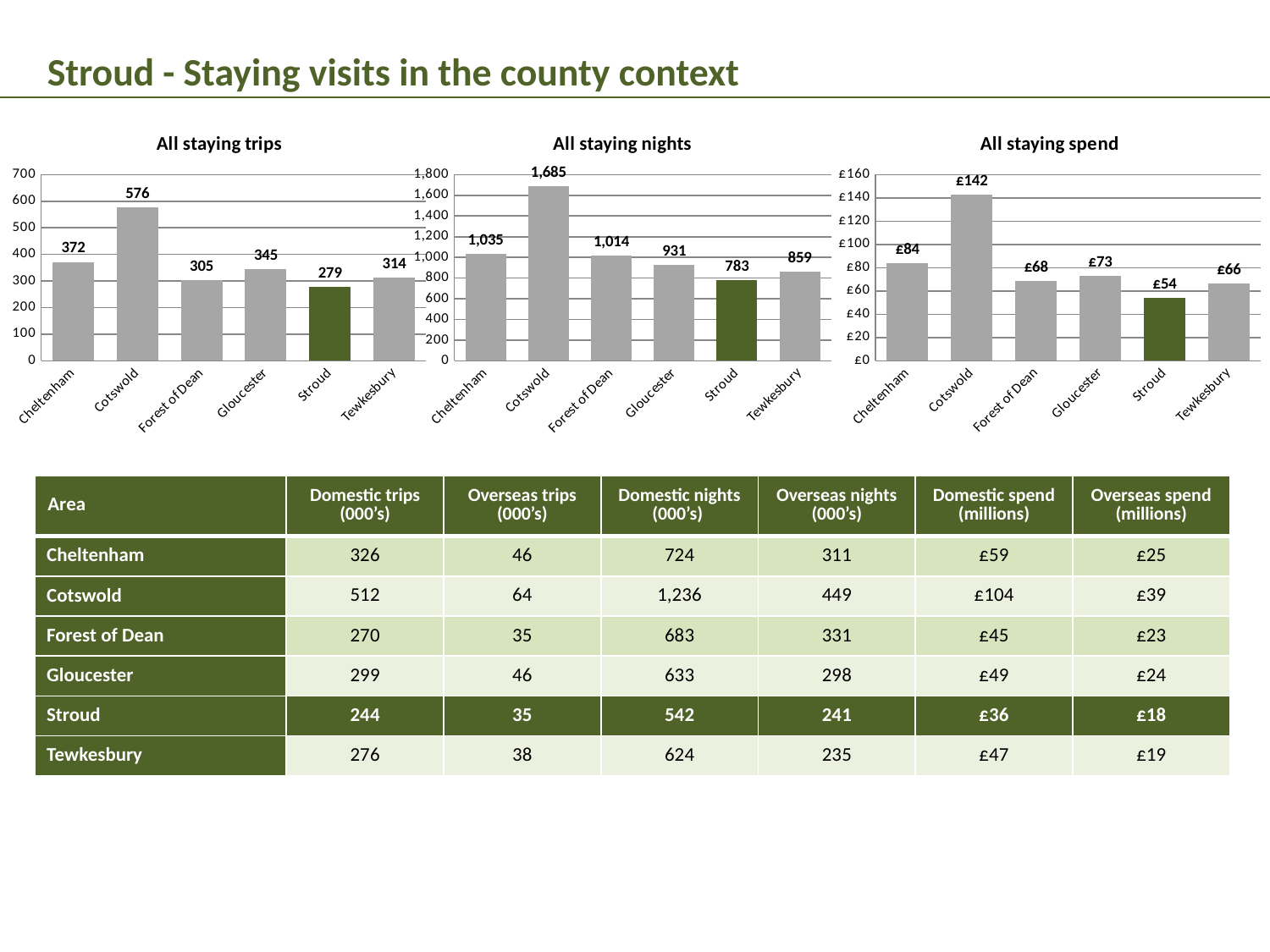
In the 'All staying spend' chart, which bar is coloured dark green rather than grey? Stroud In the 'All staying nights' chart, what is the value for Cotswold? 1,685 In the 'All staying spend' chart, which area has the lowest value? Stroud In the 'All staying trips' chart, which area has the lowest value? Stroud In the 'All staying spend' chart, what is the value for Stroud? £54 How many areas are shown in the 'All staying trips' chart? 6 In the 'All staying trips' chart, what is the value for Stroud? 279 In the 'All staying nights' chart, what is the difference between Cheltenham and Stroud? 252 In the 'All staying nights' chart, which is larger, Gloucester or Tewkesbury? Gloucester In the 'All staying trips' chart, which area has the highest value? Cotswold In the 'All staying spend' chart, what is the difference between Cotswold and Cheltenham? £58 What type of chart is the 'All staying nights' chart? Bar chart